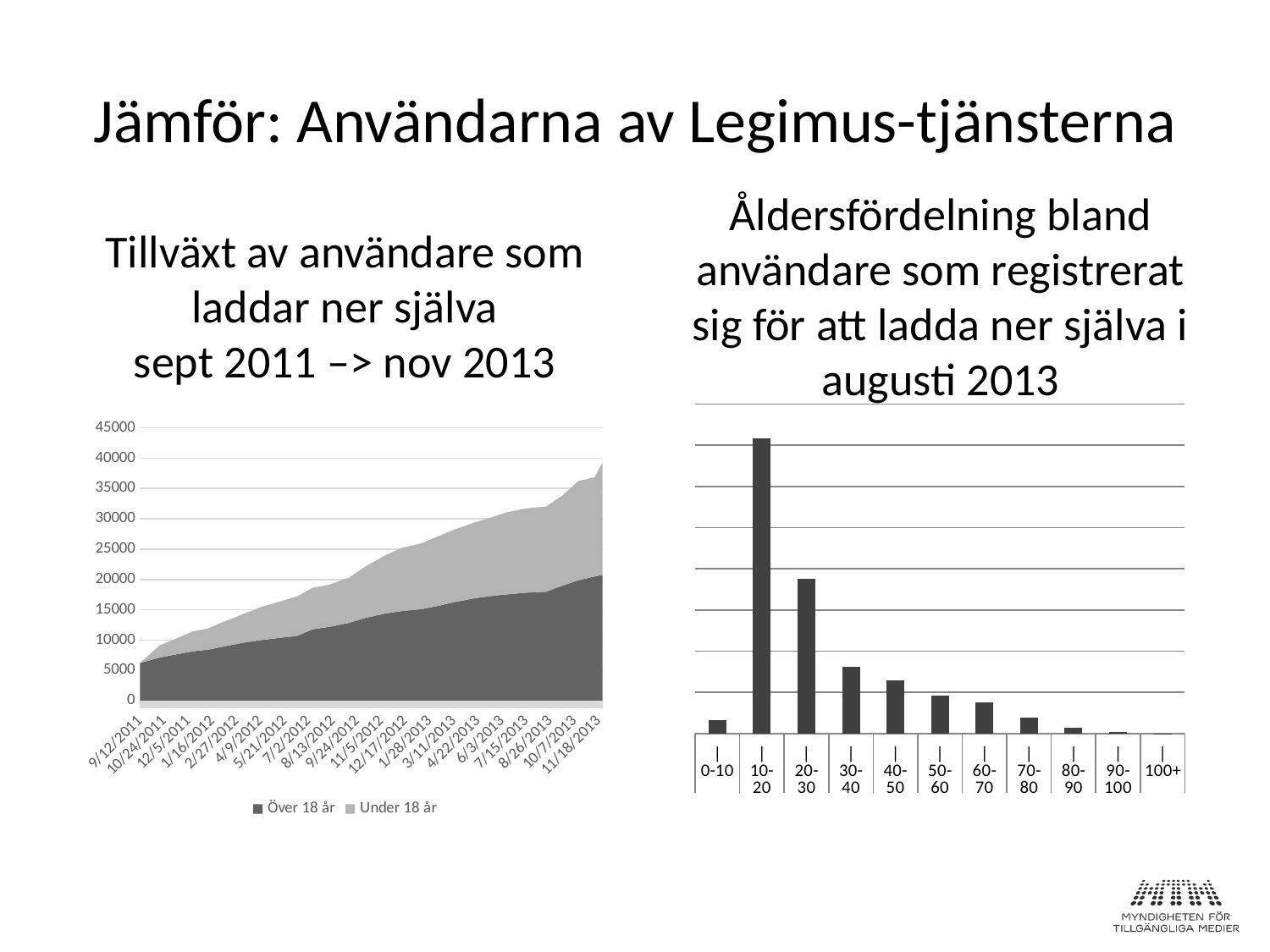
In the right chart, which is larger, the value for 20-30 or the value for 30-40? 20-30 In the left chart, do the total values rise or fall from 9/12/2011 to 11/18/2013? Rise What type of chart is the right chart, 'Åldersfördelning bland användare som registrerat sig för att ladda ner själva i augusti 2013'? Bar chart How many series does the legend of the left chart list? 2 In the left chart, is the value for 'Över 18 år' at 11/18/2013 greater or less than 15000? greater How many age categories are shown on the x axis of the right chart? 11 What type of chart is the left chart, 'Tillväxt av användare som laddar ner själva sept 2011 –> nov 2013'? Area chart What are the two series named in the legend of the left chart? Över 18 år and Under 18 år In the right chart, which is larger, the value for 0-10 or the value for 10-20? 10-20 In the right chart, which age group has the highest value? 10-20 In the left chart, is the total number of users at 9/12/2011 greater or less than 10000? less In the left chart, is the total number of users at 11/18/2013 greater or less than 35000? greater